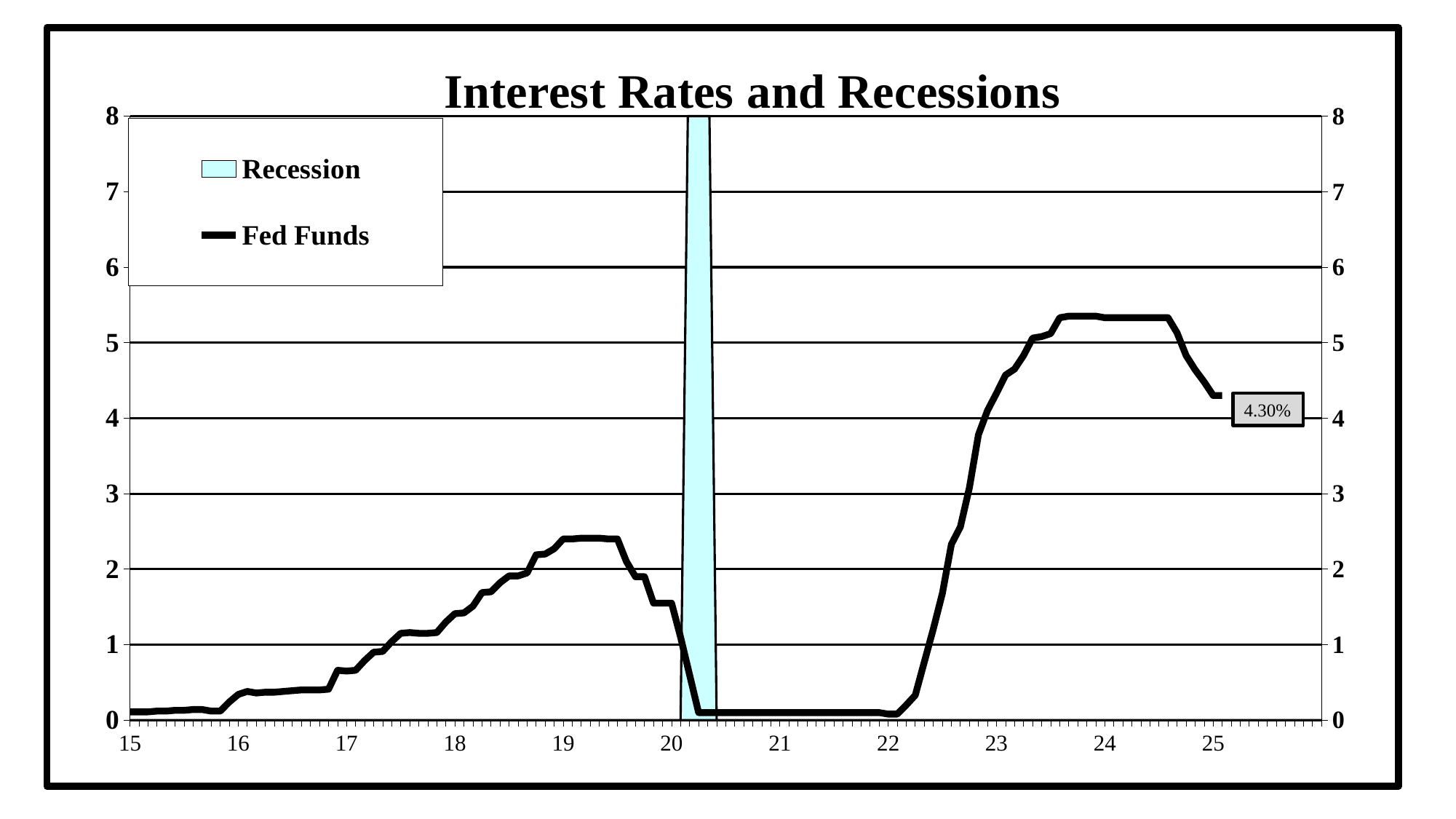
How many entries does the legend list? 2 Is the Fed Funds value at 19 greater or less than 2? greater What does the shaded light blue area in the chart represent, according to the legend? Recession What is the value shown by the data label at the end of the Fed Funds line? 4.30% Does the Fed Funds line rise or fall between 22 and 23? rise What kind of chart is used to show the Fed Funds series? line chart What is the title of the chart? Interest Rates and Recessions Is the Fed Funds value at 24 greater or less than 5? greater How many year labels are shown on the x axis? 11 Is the Fed Funds value at 21 greater or less than 1? less Which is larger, the Fed Funds value at 24 or at 19? 24 Does the Fed Funds line rise or fall between 19.5 and 20.5? fall